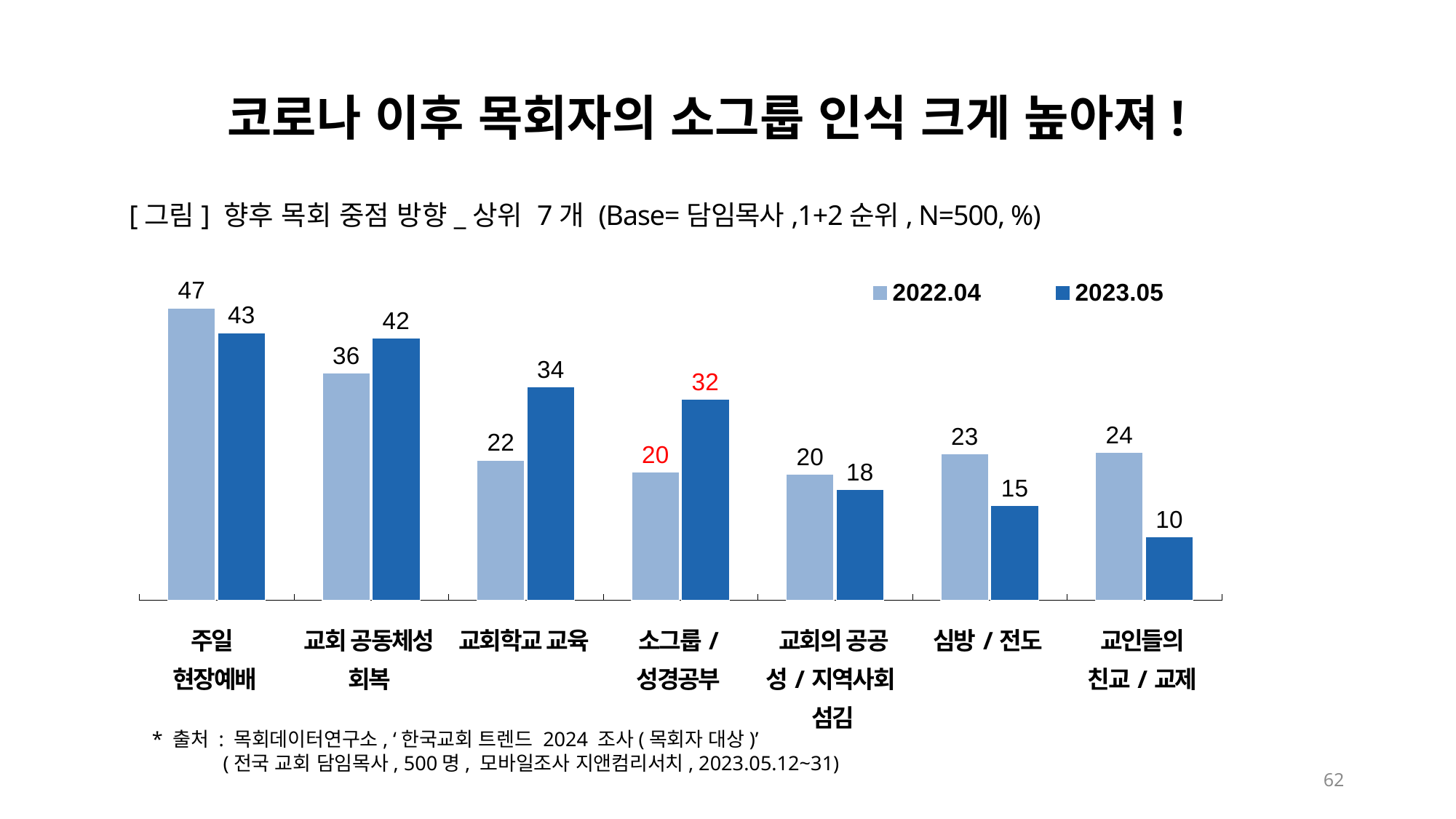
How many categories are shown on the x axis of the chart? 7 Which category has the highest 2023.05 value? 주일 현장예배 Which category has the lowest 2023.05 value? 교인들의 친교 / 교제 What is the difference between the 2022.04 and 2023.05 values for 교인들의 친교 / 교제? 14 What is the difference between the 2023.05 and 2022.04 values for 소그룹 / 성경공부? 12 How many series does the legend list? 2 For 교회학교 교육, which is larger: the 2022.04 value or the 2023.05 value? 2023.05 For 심방 / 전도, which is larger: the 2022.04 value or the 2023.05 value? 2022.04 What is the 2022.04 value for 주일 현장예배? 47 What is the 2023.05 value for 교인들의 친교 / 교제? 10 What is the 2023.05 value for 소그룹 / 성경공부? 32 What kind of chart is shown on the slide? Bar chart